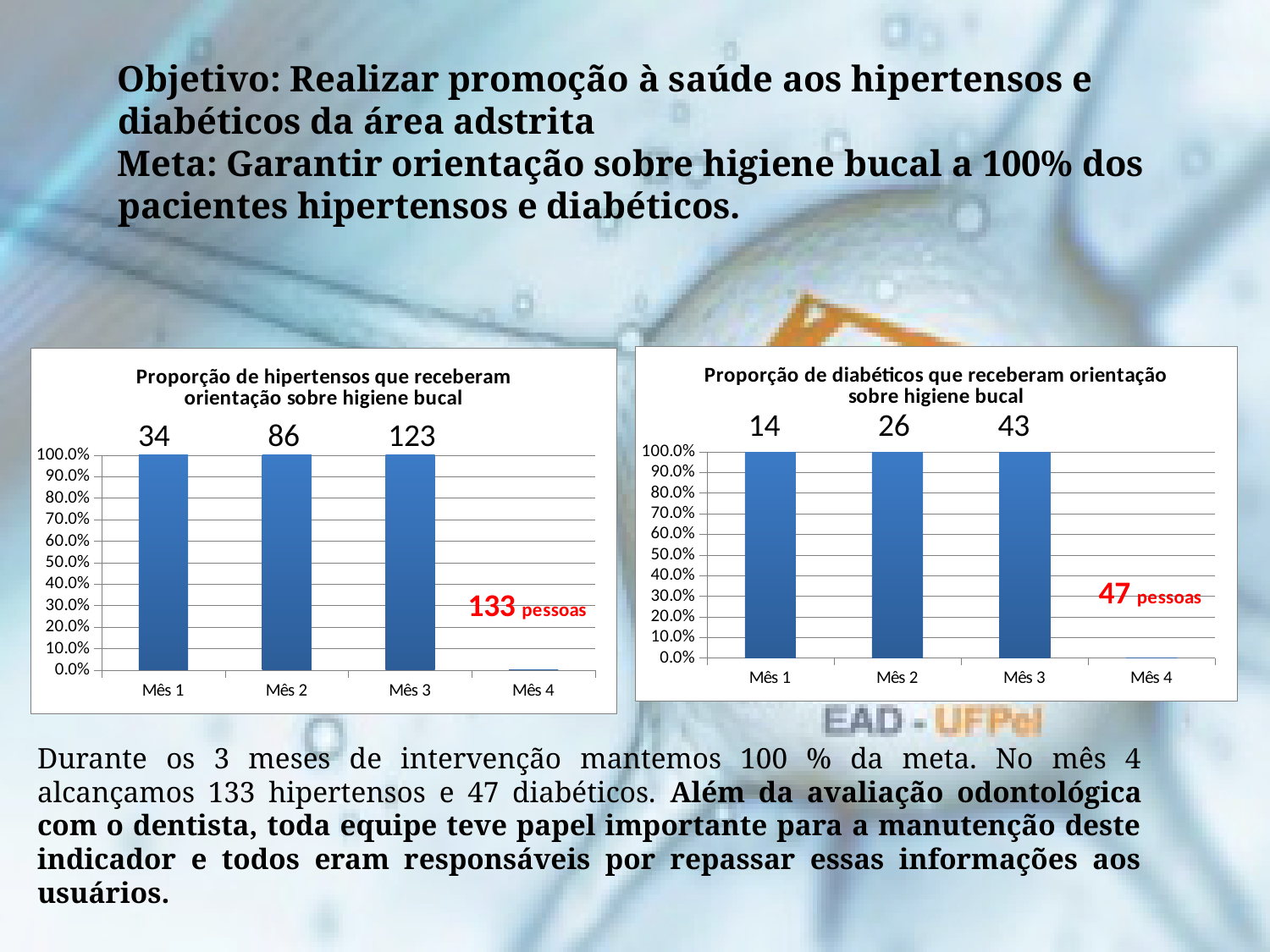
In the right chart (Proporção de diabéticos), what number is printed above the bar for Mês 2? 26 What red annotation is written inside the right chart (Proporção de diabéticos)? 47 pessoas How many month categories are shown on the x axis of the left chart (Proporção de hipertensos)? 4 In the left chart (Proporção de hipertensos), what is the difference between the numbers printed above the bars for Mês 3 and Mês 1? 89 In the right chart (Proporção de diabéticos), what is the difference between the numbers printed above the bars for Mês 3 and Mês 1? 29 In the right chart (Proporção de diabéticos), is the bar for Mês 4 greater or less than 10.0%? less In the left chart (Proporção de hipertensos), what number is printed above the bar for Mês 3? 123 In the right chart (Proporção de diabéticos), what number is printed above the bar for Mês 3? 43 In the left chart (Proporção de hipertensos), is the bar for Mês 2 greater or less than 50.0%? greater In the left chart (Proporção de hipertensos), what number is printed above the bar for Mês 1? 34 What kind of chart is the right chart (Proporção de diabéticos)? Bar chart What is the title of the left chart? Proporção de hipertensos que receberam orientação sobre higiene bucal